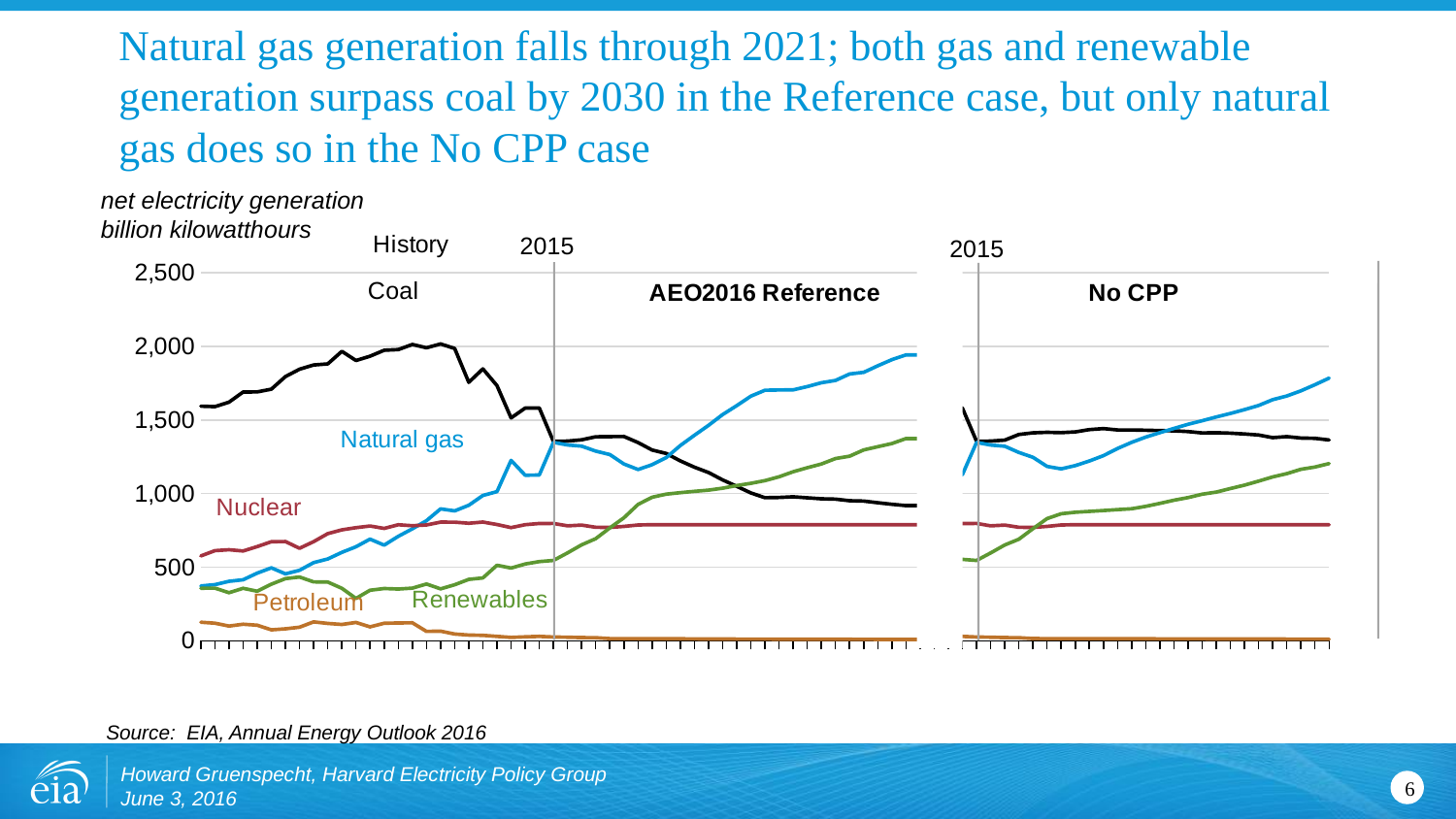
In the AEO2016 Reference panel, is the value for coal at the end of the projection greater or less than 1,000? less What kind of chart is shown on the slide? line chart Which series is the highest at the start of the History period? Coal How many generation sources (series) are labeled on the chart? 5 In the AEO2016 Reference panel, which series is highest at the end of the projection? Natural gas In the No CPP panel, which is larger at the end of the projection, coal or renewables? Coal In the AEO2016 Reference panel, is the value for natural gas at the end of the projection greater or less than 1,500? greater What unit is the y axis measured in? billion kilowatthours Which series is the lowest throughout the chart? Petroleum In the No CPP panel, is the value for coal at the end of the projection greater or less than 1,500? less In the AEO2016 Reference panel, does coal generation rise or fall over the projection period? fall Which year marks the boundary between History and the projections? 2015